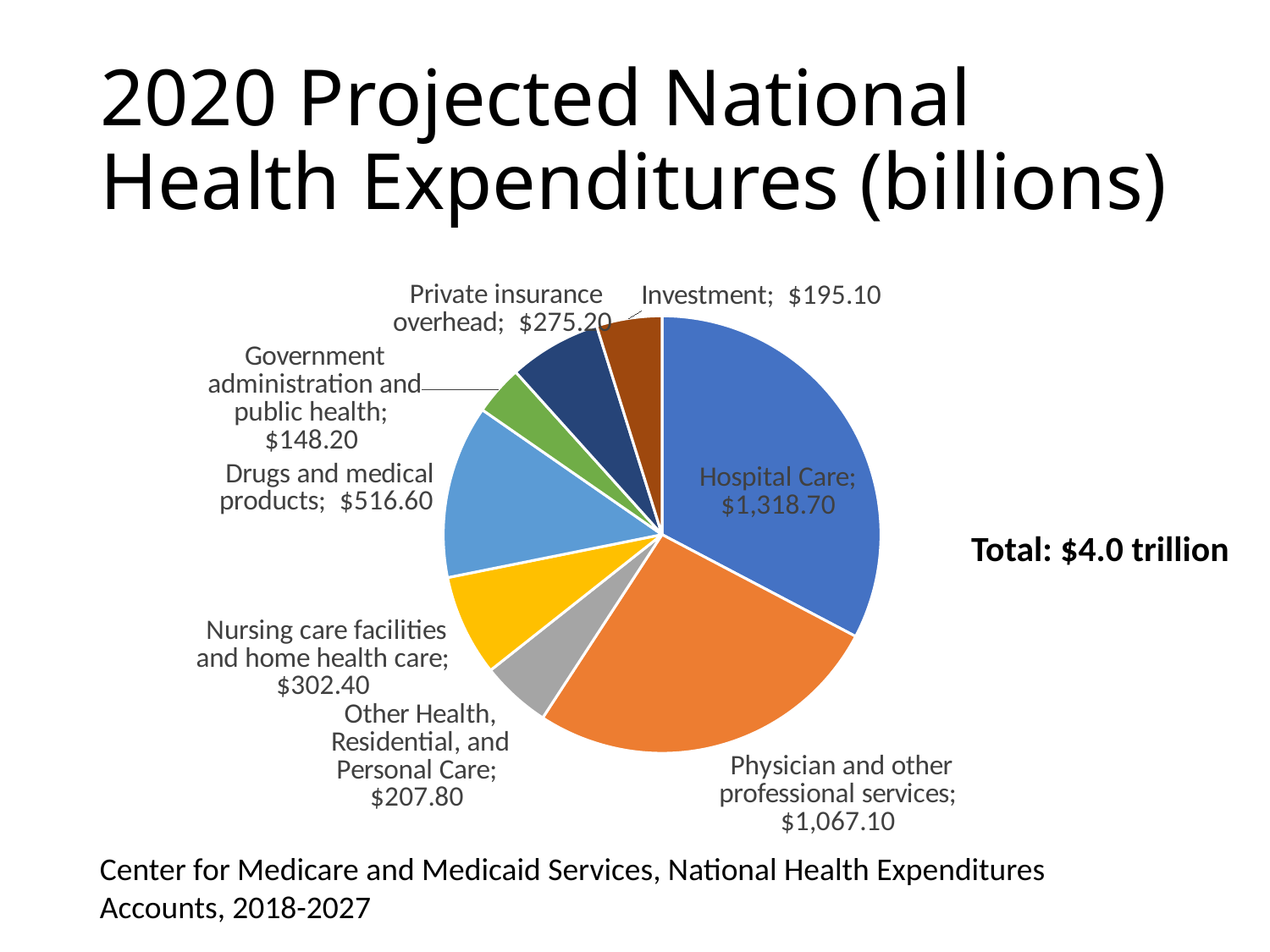
What is the value for Investment? $195.10 What is the value for Hospital Care? $1,318.70 Which is larger, Nursing care facilities and home health care or Other Health, Residential, and Personal Care? Nursing care facilities and home health care What is the difference between Private insurance overhead and Investment? $80.10 How many slices does the pie chart have? 8 Which category has the smallest slice? Government administration and public health What total is stated next to the pie chart? $4.0 trillion Which category has the largest slice? Hospital Care What is the difference between Hospital Care and Physician and other professional services? $251.60 What kind of chart is shown on the slide? Pie chart What is the value for Government administration and public health? $148.20 What is the value for Drugs and medical products? $516.60